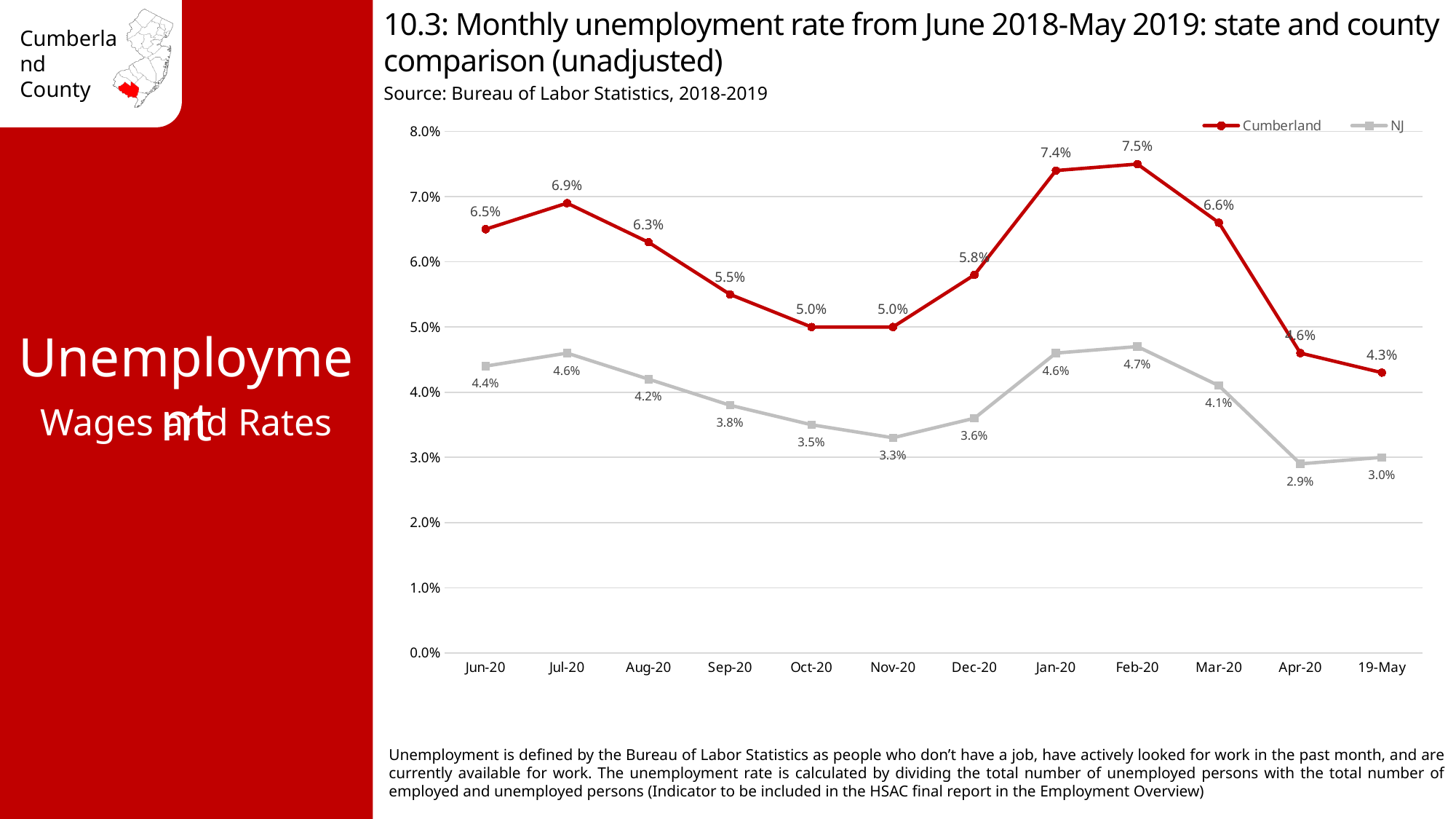
Which series has the higher value in Sep-20, Cumberland or NJ? Cumberland In which month does the NJ series reach its lowest value? Apr-20 What is the Cumberland unemployment rate for Feb-20? 7.5% What type of chart is shown on the slide? line chart What is the difference between the Cumberland and NJ rates in Jan-20? 2.8% How many months are plotted along the x axis? 12 What is the NJ unemployment rate for Nov-20? 3.3% In which month does the Cumberland series reach its highest value? Feb-20 What colour is the Cumberland line in the chart? red What is the difference between the Cumberland rate in Jul-20 and in Oct-20? 1.9% Does the Cumberland series rise or fall from Feb-20 to 19-May? fall How many series does the legend list? 2